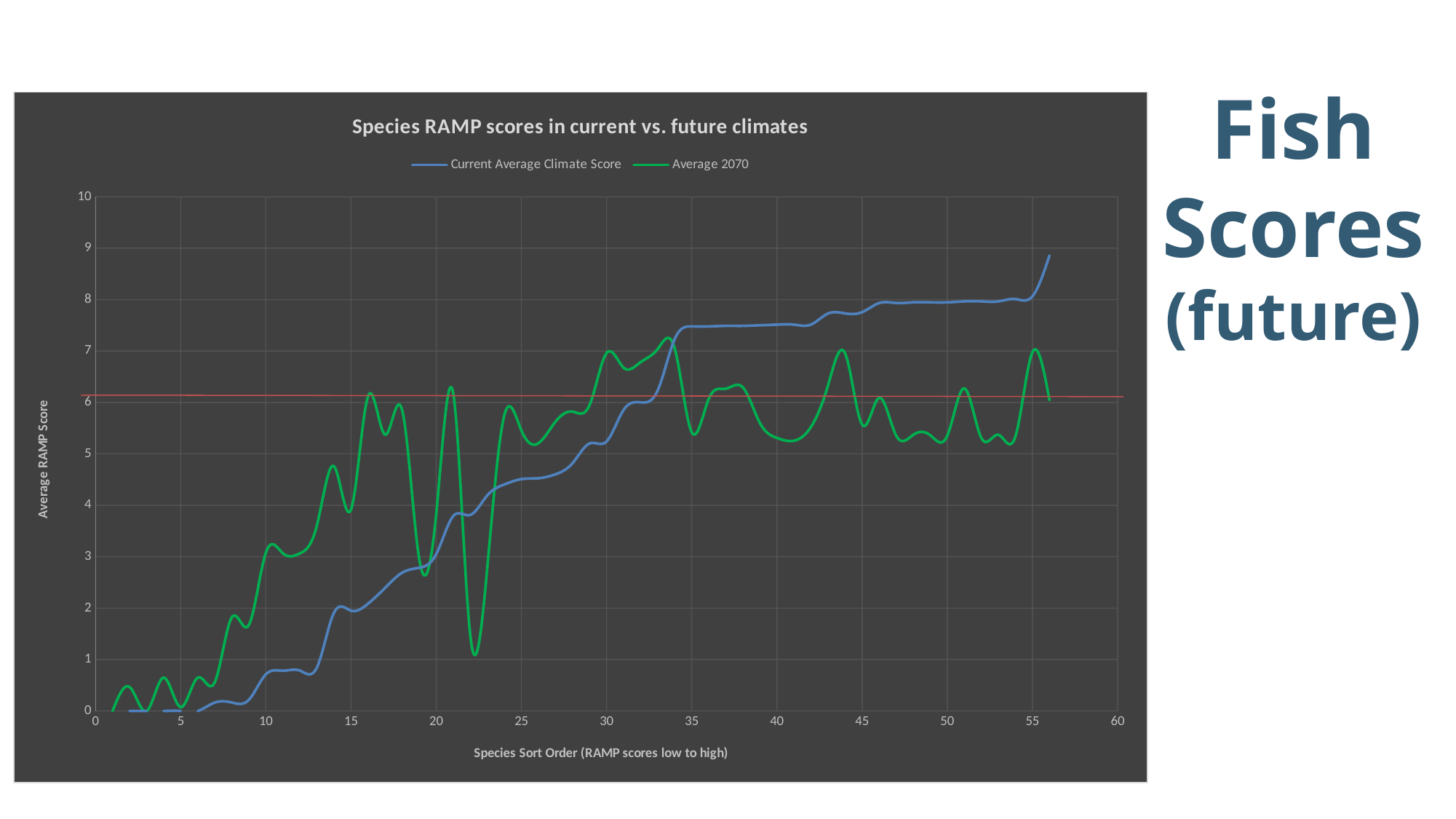
Is the Current Average Climate Score at species sort order 35 greater or less than 7? greater What is the title of the chart? Species RAMP scores in current vs. future climates What is the label of the vertical axis? Average RAMP Score Which series reaches the highest value anywhere on the chart? Current Average Climate Score Is the Average 2070 value at species sort order 30 greater or less than 6? greater Is the Current Average Climate Score at species sort order 10 greater or less than 1? less What kind of chart is shown on the slide? Line chart Does the Current Average Climate Score line generally rise or fall as the species sort order increases? Rise At species sort order 35, which series has the higher value: Current Average Climate Score or Average 2070? Current Average Climate Score How many series does the legend list? 2 At species sort order 10, which series has the higher value: Current Average Climate Score or Average 2070? Average 2070